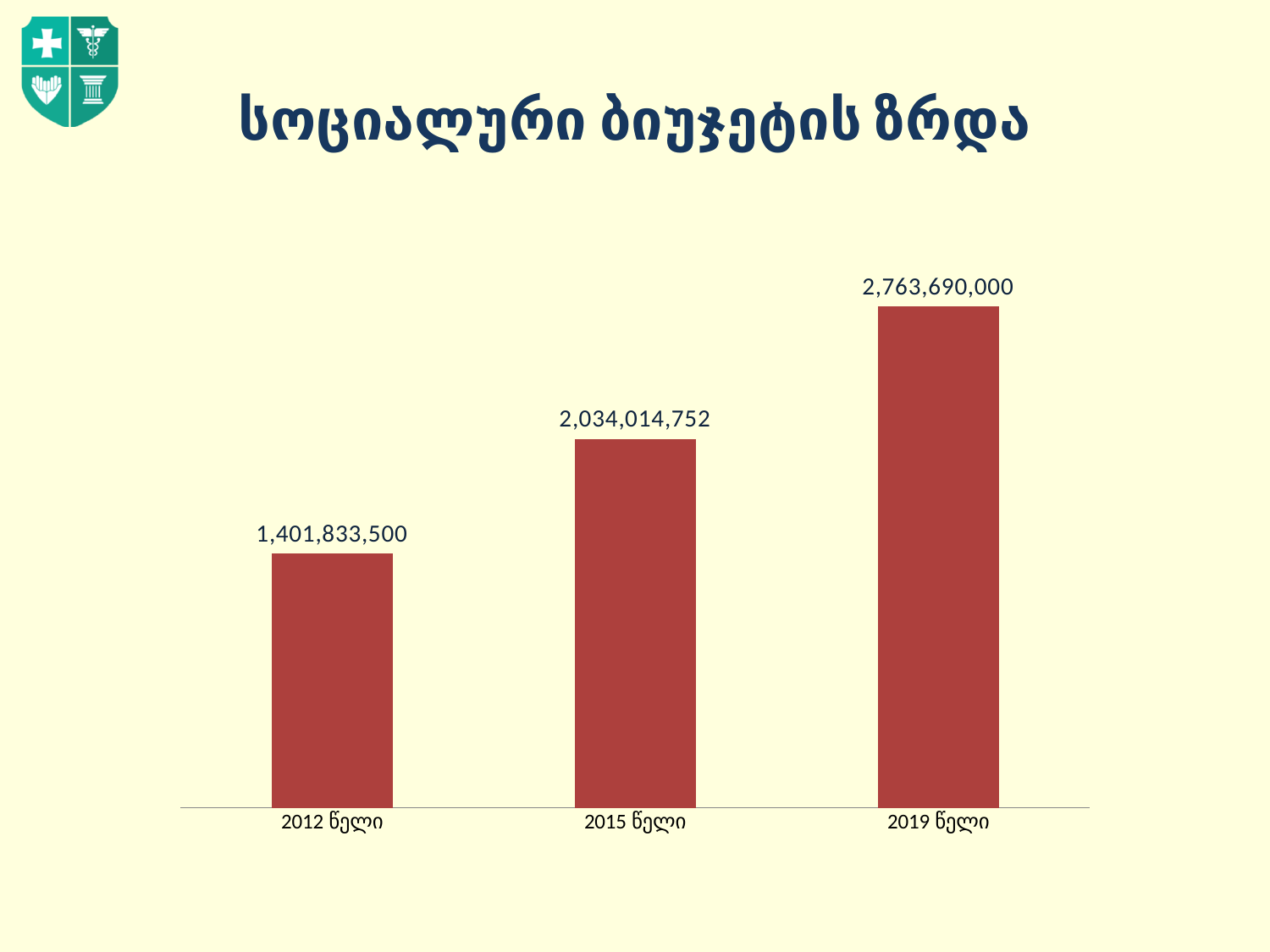
What is the difference between the values for 2015 წელი and 2012 წელი? 632,181,252 What is the value for 2015 წელი? 2,034,014,752 How many bars are shown in the chart? 3 What is the difference between the values for 2019 წელი and 2012 წელი? 1,361,856,500 Which year has the lowest value? 2012 წელი What is the value for 2012 წელი? 1,401,833,500 Which is larger, the value for 2015 წელი or the value for 2019 წელი? 2019 წელი What kind of chart is shown on the slide? Bar chart What is the value for 2019 წელი? 2,763,690,000 Do the values rise or fall from 2012 წელი to 2019 წელი? Rise Which year has the highest value? 2019 წელი What is the difference between the values for 2019 წელი and 2015 წელი? 729,675,248